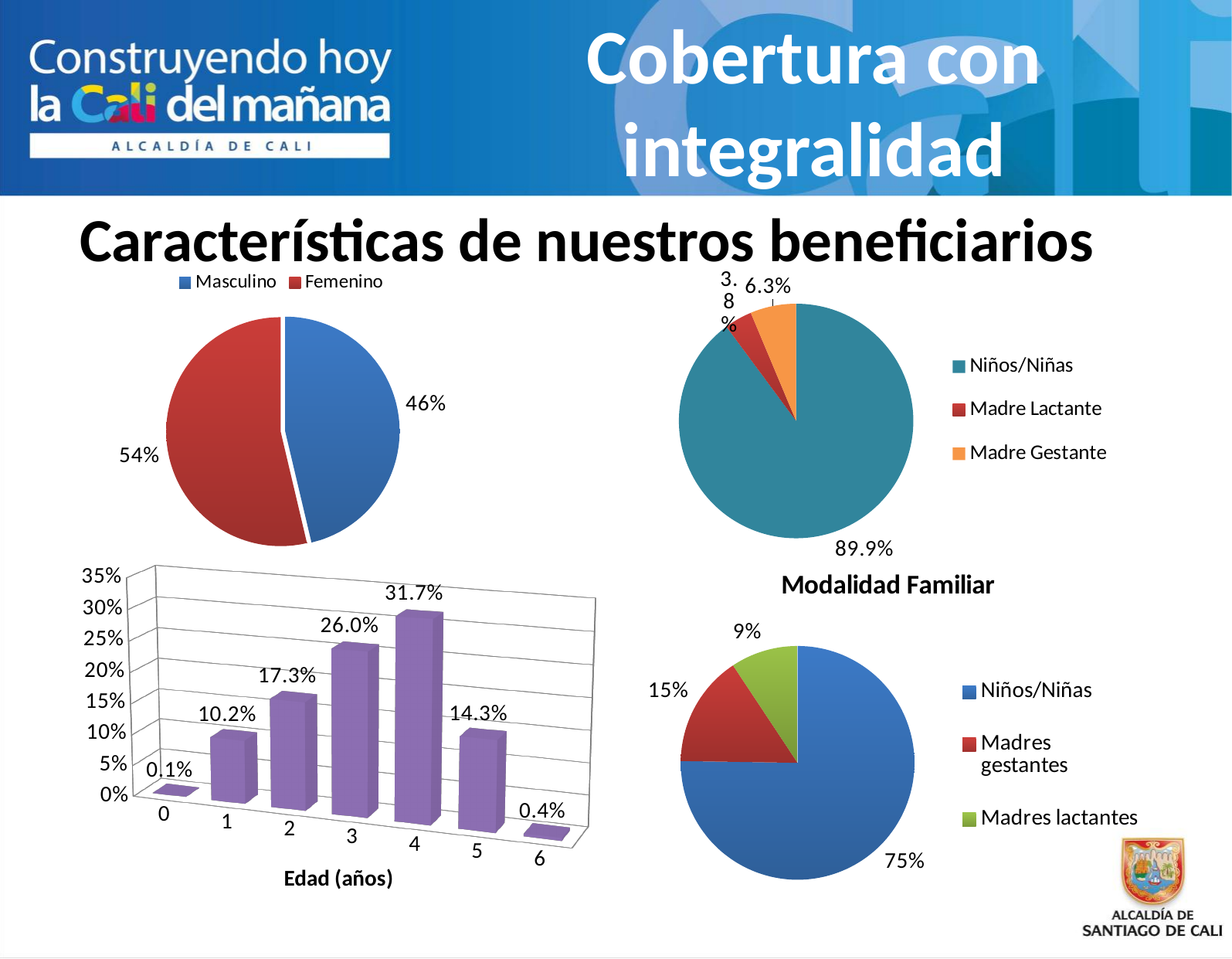
How many entries does the legend of the top-right pie chart list? 3 In the top-left pie chart, what percentage is shown for Femenino? 54% In the bottom-left chart (Edad (años)), which age has the lowest value? 0 In the bottom-left chart (Edad (años)), what is the value for age 4? 31.7% In the Modalidad Familiar pie chart, what percentage is shown for Madres gestantes? 15% What kind of chart is the bottom-left chart with the x axis labelled Edad (años)? Bar chart In the top-right pie chart, what percentage is shown for Niños/Niñas? 89.9% In the bottom-left chart (Edad (años)), what is the difference between the values for age 3 and age 2? 8.7% In the top-right pie chart, what percentage is shown for Madre Gestante? 6.3% In the top-left pie chart, which slice is larger, Masculino or Femenino? Femenino In the top-left pie chart, what percentage is shown for Masculino? 46% In the top-left pie chart, what is the difference between the Femenino and Masculino percentages? 8%